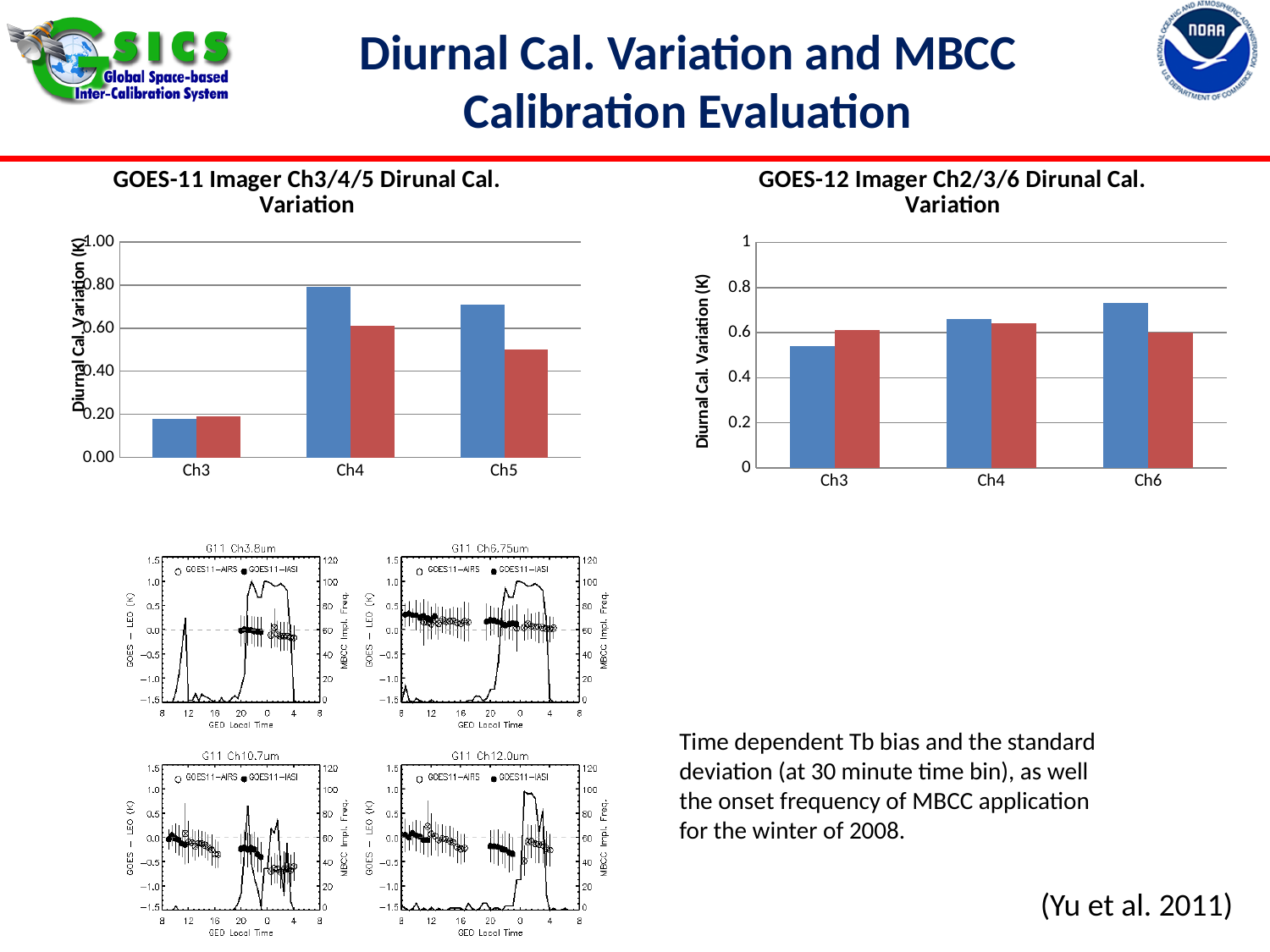
In the GOES-11 Imager Ch3/4/5 Diurnal Cal. Variation chart, which channel has the highest blue bar? Ch4 In the GOES-12 Imager Ch2/3/6 Diurnal Cal. Variation chart, is the blue bar for Ch3 greater or less than 0.4? greater In the GOES-11 Imager Ch3/4/5 Diurnal Cal. Variation chart, is the red bar for Ch3 greater or less than 0.40? less How many channel categories are shown on the x axis of the GOES-11 Imager Ch3/4/5 Diurnal Cal. Variation chart? 3 In the GOES-11 Imager Ch3/4/5 Diurnal Cal. Variation chart, which channel has the lowest red bar? Ch3 In the GOES-11 Imager Ch3/4/5 Diurnal Cal. Variation chart, which is larger for Ch5, the blue bar or the red bar? the blue bar In the GOES-12 Imager Ch2/3/6 Diurnal Cal. Variation chart, which is larger for Ch3, the blue bar or the red bar? the red bar What is the y-axis label of the GOES-12 Imager Ch2/3/6 Diurnal Cal. Variation chart? Diurnal Cal. Variation (K) What kind of chart is the GOES-11 Imager Ch3/4/5 Diurnal Cal. Variation chart? bar chart In the GOES-11 Imager Ch3/4/5 Diurnal Cal. Variation chart, is the blue bar for Ch4 greater or less than 0.60? greater In the GOES-12 Imager Ch2/3/6 Diurnal Cal. Variation chart, which channel has the highest blue bar? Ch6 What kind of chart is the GOES-12 Imager Ch2/3/6 Diurnal Cal. Variation chart? bar chart